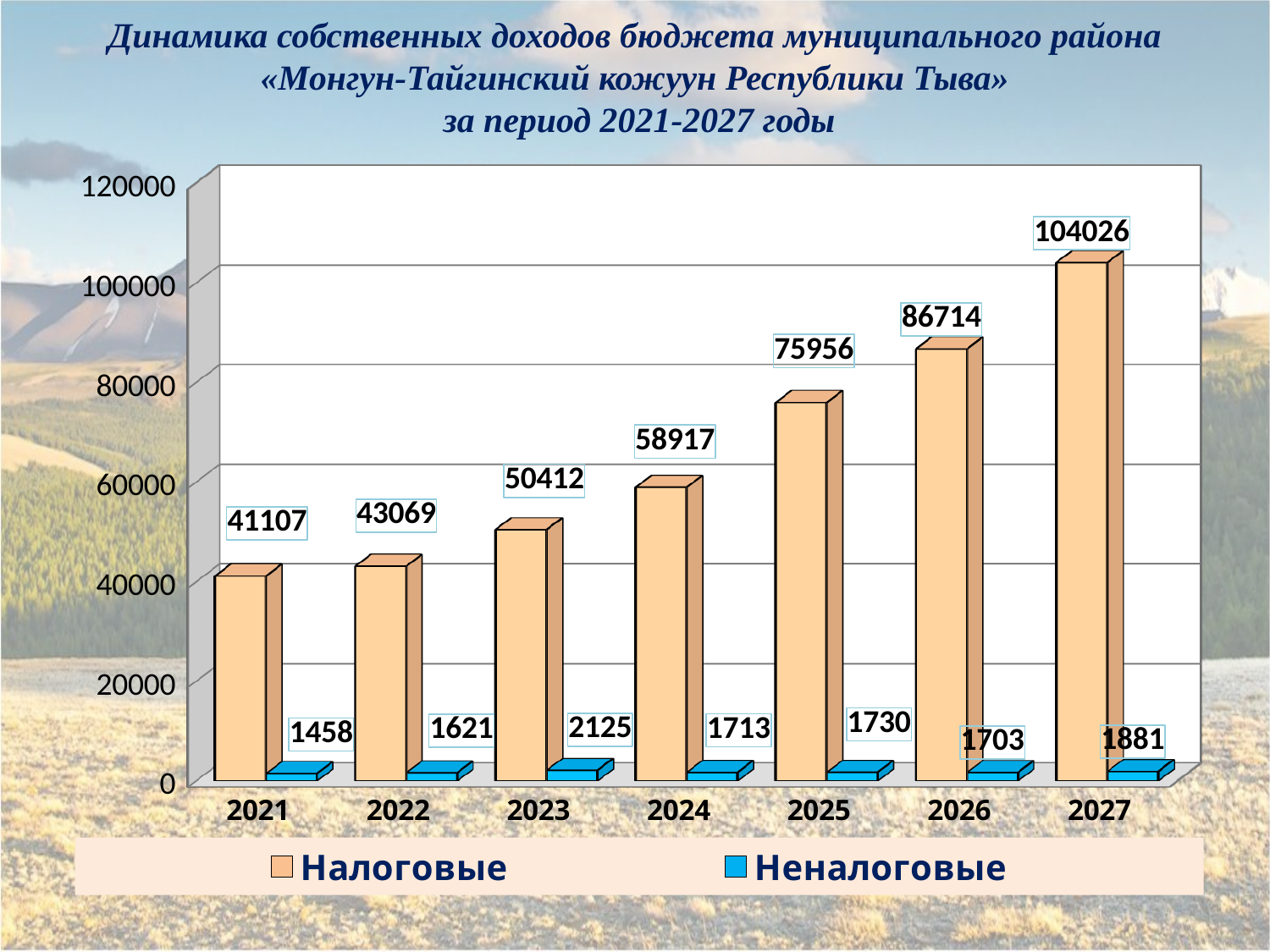
What is the difference between the Налоговые values for 2027 and 2026? 17312 What is the value of Налоговые for 2027? 104026 How many years are shown on the x axis? 7 Which is larger, the Неналоговые value for 2025 or for 2026? 2025 Which year has the lowest Налоговые value? 2021 What kind of chart is shown on the slide? bar chart Which year has the highest Неналоговые value? 2023 How many series does the legend list? 2 Do the Налоговые values rise or fall from 2021 to 2027? rise What is the value of Налоговые for 2024? 58917 What is the value of Неналоговые for 2023? 2125 Is the Налоговые value for 2025 greater or less than 80000? less